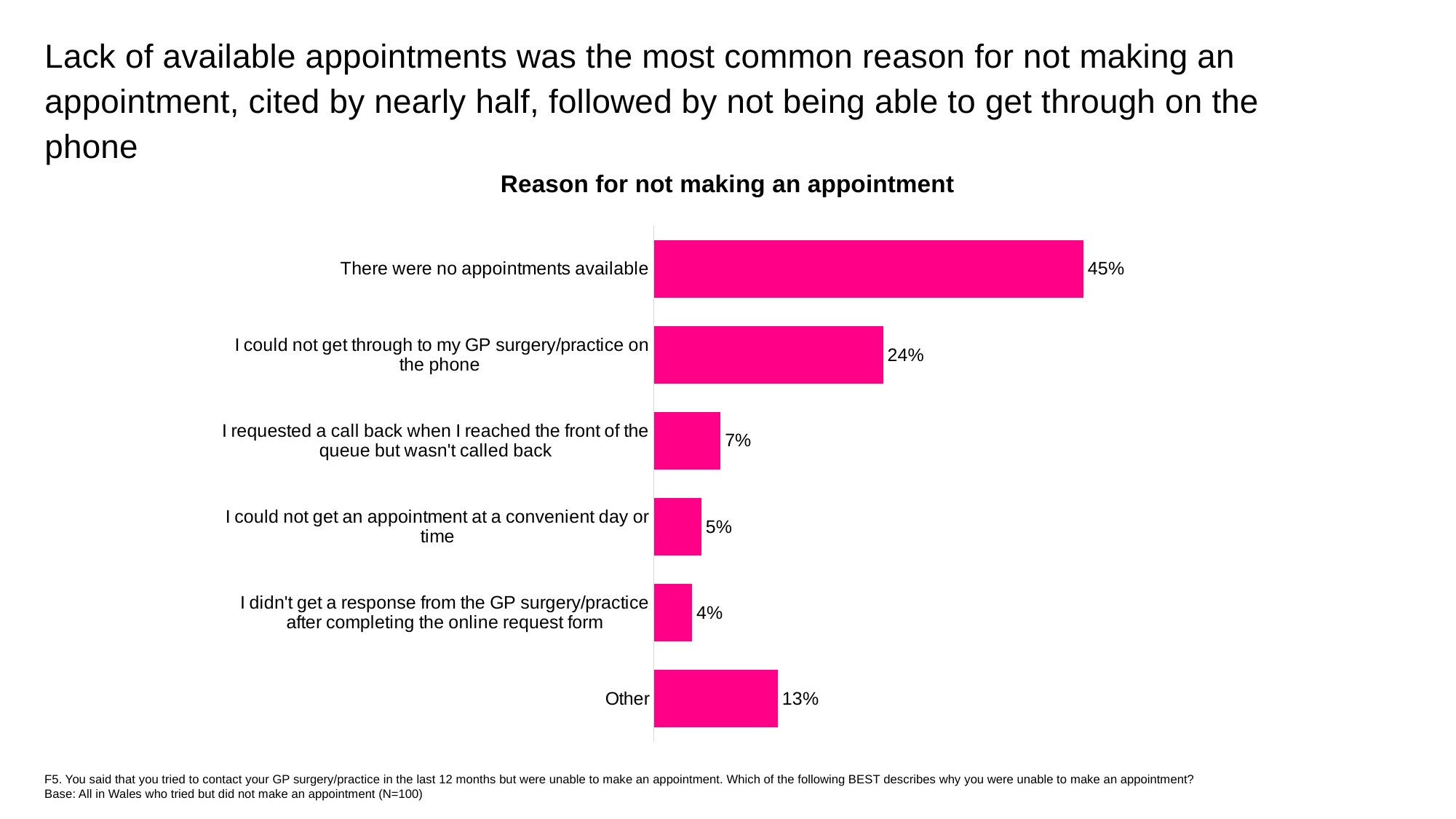
What percentage of respondents said there were no appointments available? 45% What is the title of the chart? Reason for not making an appointment Which is larger: the value for 'I requested a call back when I reached the front of the queue but wasn't called back' or 'I could not get an appointment at a convenient day or time'? I requested a call back when I reached the front of the queue but wasn't called back What is the difference between the value for 'Other' and 'I could not get an appointment at a convenient day or time'? 8% Which reason for not making an appointment has the highest value? There were no appointments available What percentage said they didn't get a response from the GP surgery/practice after completing the online request form? 4% What is the difference between the value for 'There were no appointments available' and 'I could not get through to my GP surgery/practice on the phone'? 21% Which reason for not making an appointment has the lowest value? I didn't get a response from the GP surgery/practice after completing the online request form What is the value for 'Other'? 13% What kind of chart is shown on the slide? Bar chart How many reasons (categories) are shown in the chart? 6 What percentage of respondents said they could not get through to their GP surgery/practice on the phone? 24%